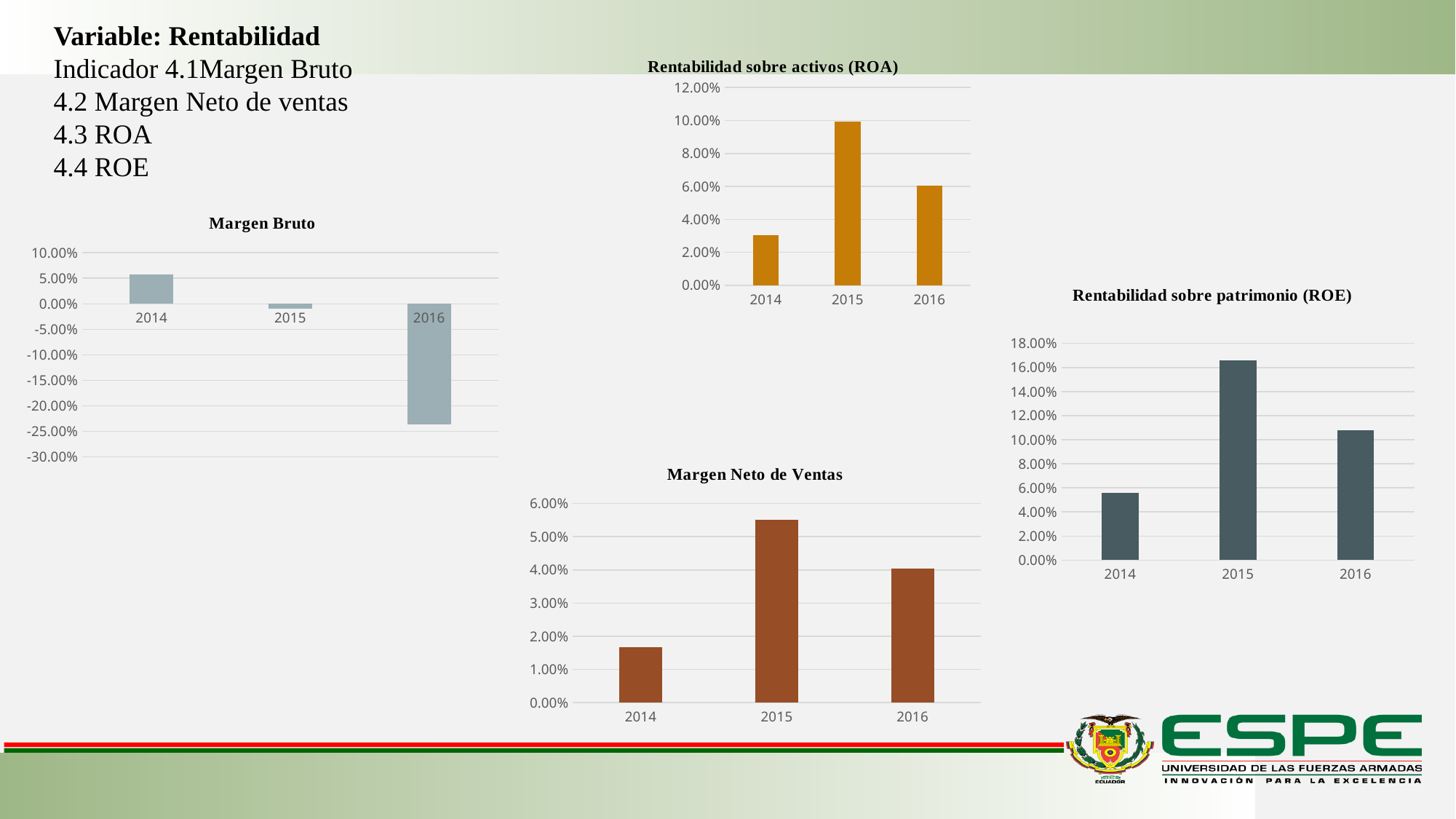
In the Margen Neto de Ventas chart, is the value for 2014 greater or less than 2.00%? less How many years are shown on the x axis of the Margen Neto de Ventas chart? 3 In the Rentabilidad sobre patrimonio (ROE) chart, which year has the lowest value? 2014 In the Rentabilidad sobre activos (ROA) chart, which is larger, the value for 2014 or the value for 2016? 2016 In the Rentabilidad sobre activos (ROA) chart, is the value for 2015 greater or less than 8.00%? greater In the Rentabilidad sobre activos (ROA) chart, which year has the highest value? 2015 In the Margen Bruto chart, is the value for 2016 greater or less than -20.00%? less In the Margen Neto de Ventas chart, which year has the highest value? 2015 What kind of chart is the Rentabilidad sobre patrimonio (ROE) chart? bar chart In the Margen Bruto chart, which year has the highest value? 2014 In the Margen Bruto chart, which year has the lowest value? 2016